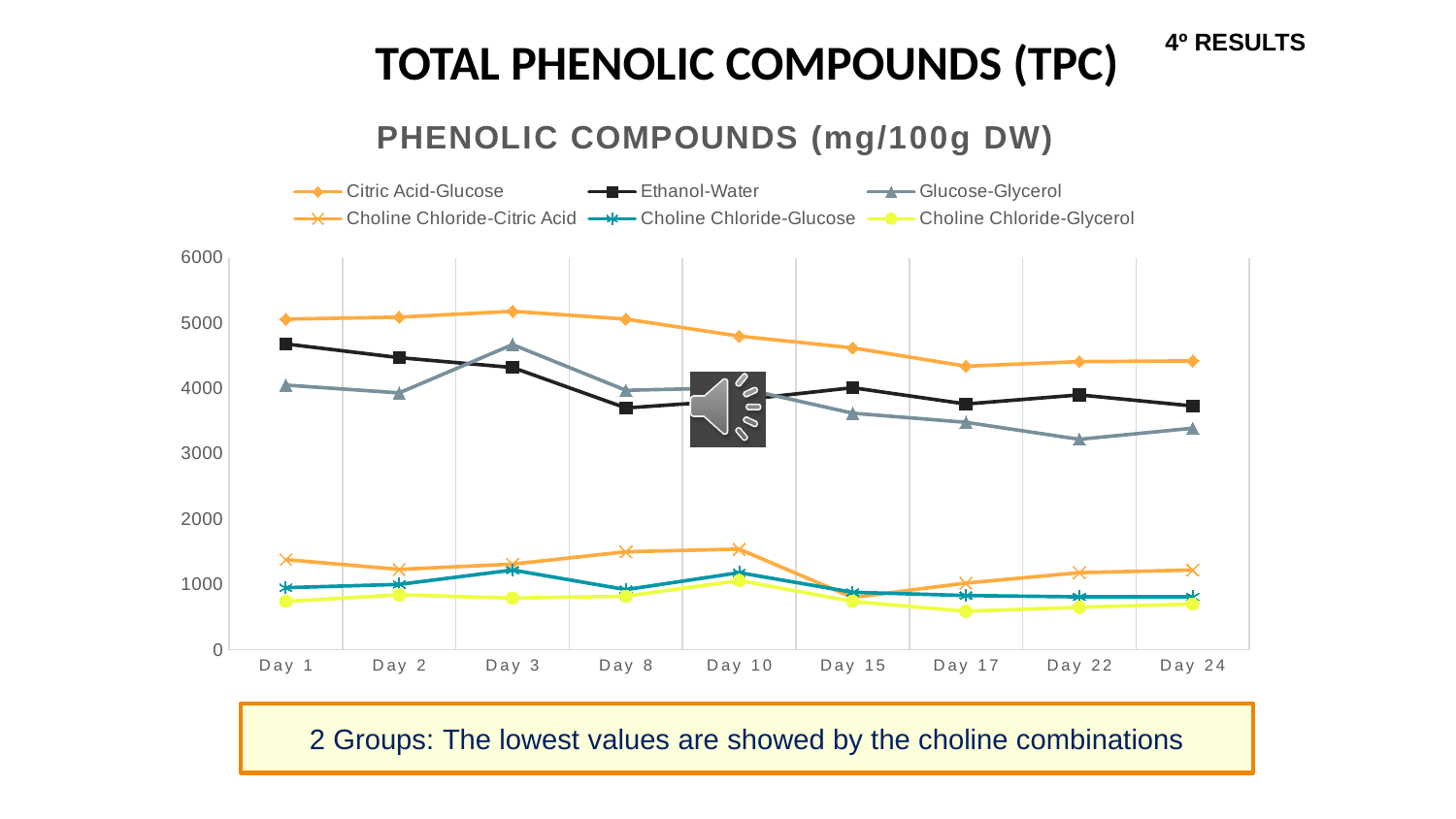
How many days (categories) are shown on the x axis? 9 Is the value for Glucose-Glycerol at Day 22 greater or less than 4000? less What kind of chart is shown on the slide? line chart Is the value for Choline Chloride-Citric Acid at Day 10 greater or less than 1000? greater Is the value for Citric Acid-Glucose at Day 3 greater or less than 5000? greater At Day 22, which is larger: Ethanol-Water or Glucose-Glycerol? Ethanol-Water Which series has the lowest value at Day 17? Choline Chloride-Glycerol At Day 3, which is larger: Ethanol-Water or Glucose-Glycerol? Glucose-Glycerol Which series has the highest value at Day 1? Citric Acid-Glucose Does the Citric Acid-Glucose series rise or fall from Day 3 to Day 17? fall What is the title of the chart? PHENOLIC COMPOUNDS (mg/100g DW) How many series does the legend list? 6